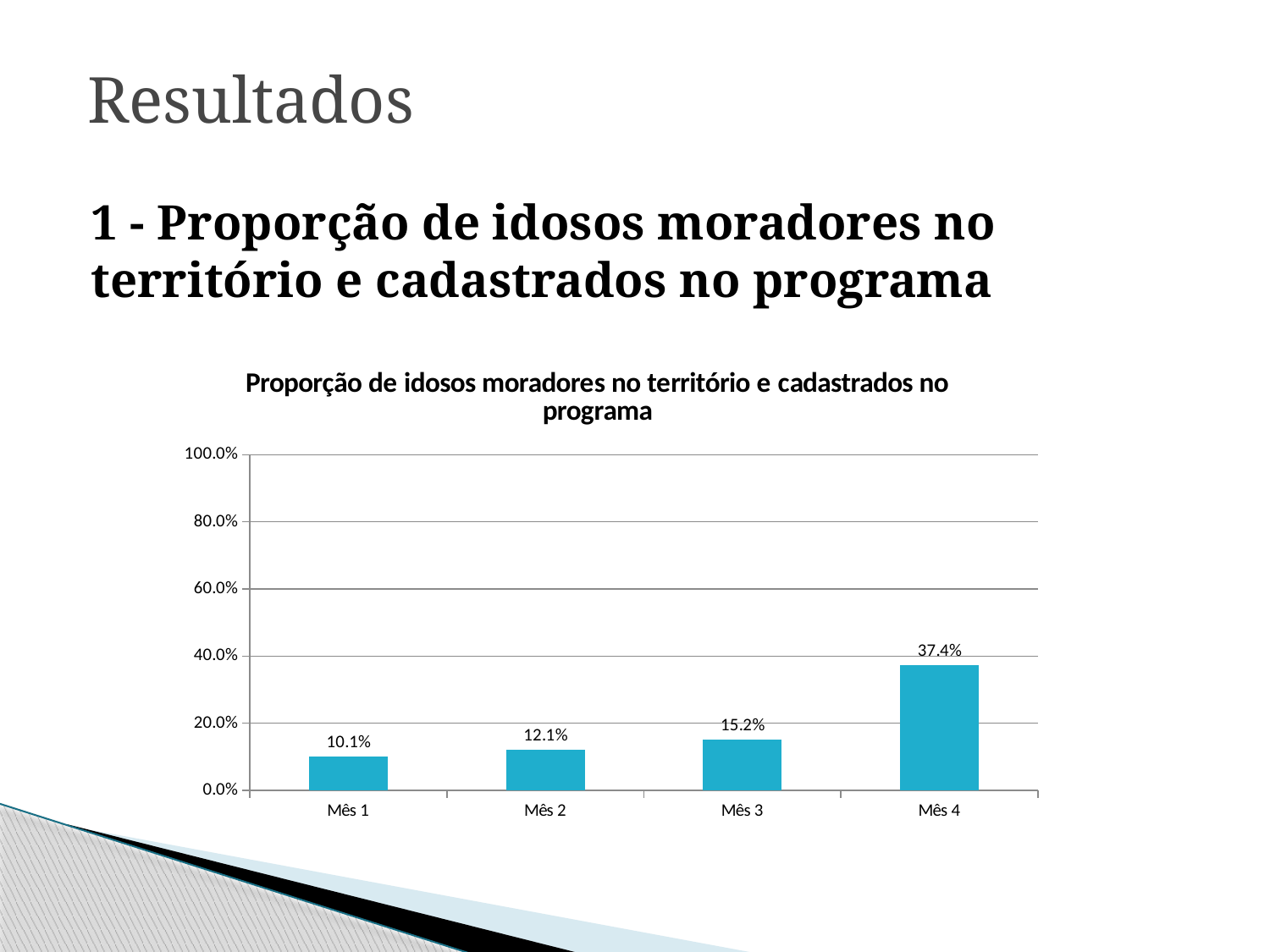
What kind of chart is shown on the slide? bar chart Which month has the lowest value? Mês 1 What is the difference between the values for Mês 4 and Mês 3? 22.2% Is the value for Mês 4 greater or less than 20.0%? greater What is the difference between the values for Mês 2 and Mês 1? 2.0% Which month has the highest value? Mês 4 Do the values rise or fall from Mês 1 to Mês 4? rise Which is larger, the value for Mês 2 or the value for Mês 3? Mês 3 What is the value for Mês 3? 15.2% What is the value for Mês 1? 10.1% What is the value for Mês 4? 37.4% How many months are shown on the x axis? 4